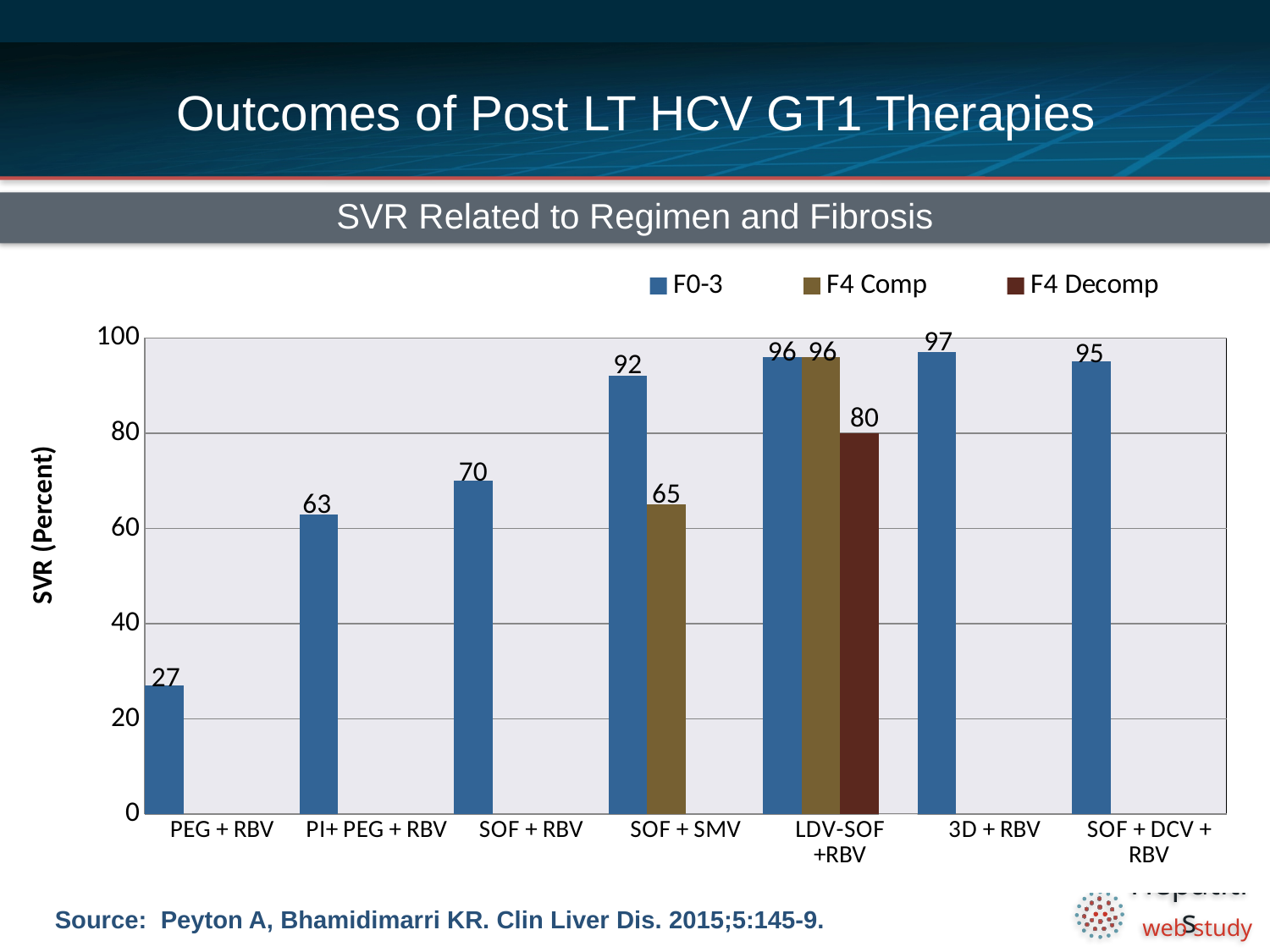
How many regimens are shown on the x axis? 7 What kind of chart is shown on the slide? bar chart What is the difference between the F0-3 SVR values for SOF + RBV and PI+ PEG + RBV? 7 Which is larger, the F0-3 value for SOF + SMV or the F0-3 value for SOF + DCV + RBV? SOF + DCV + RBV What is the label of the y axis? SVR (Percent) Which regimen has the lowest F0-3 SVR value? PEG + RBV Which regimen has the highest F0-3 SVR value? 3D + RBV What is the F4 Decomp SVR value for LDV-SOF +RBV? 80 What is the F0-3 SVR value for PEG + RBV? 27 Which regimen has values for all three fibrosis series? LDV-SOF +RBV What is the F4 Comp SVR value for SOF + SMV? 65 How many series does the legend list? 3